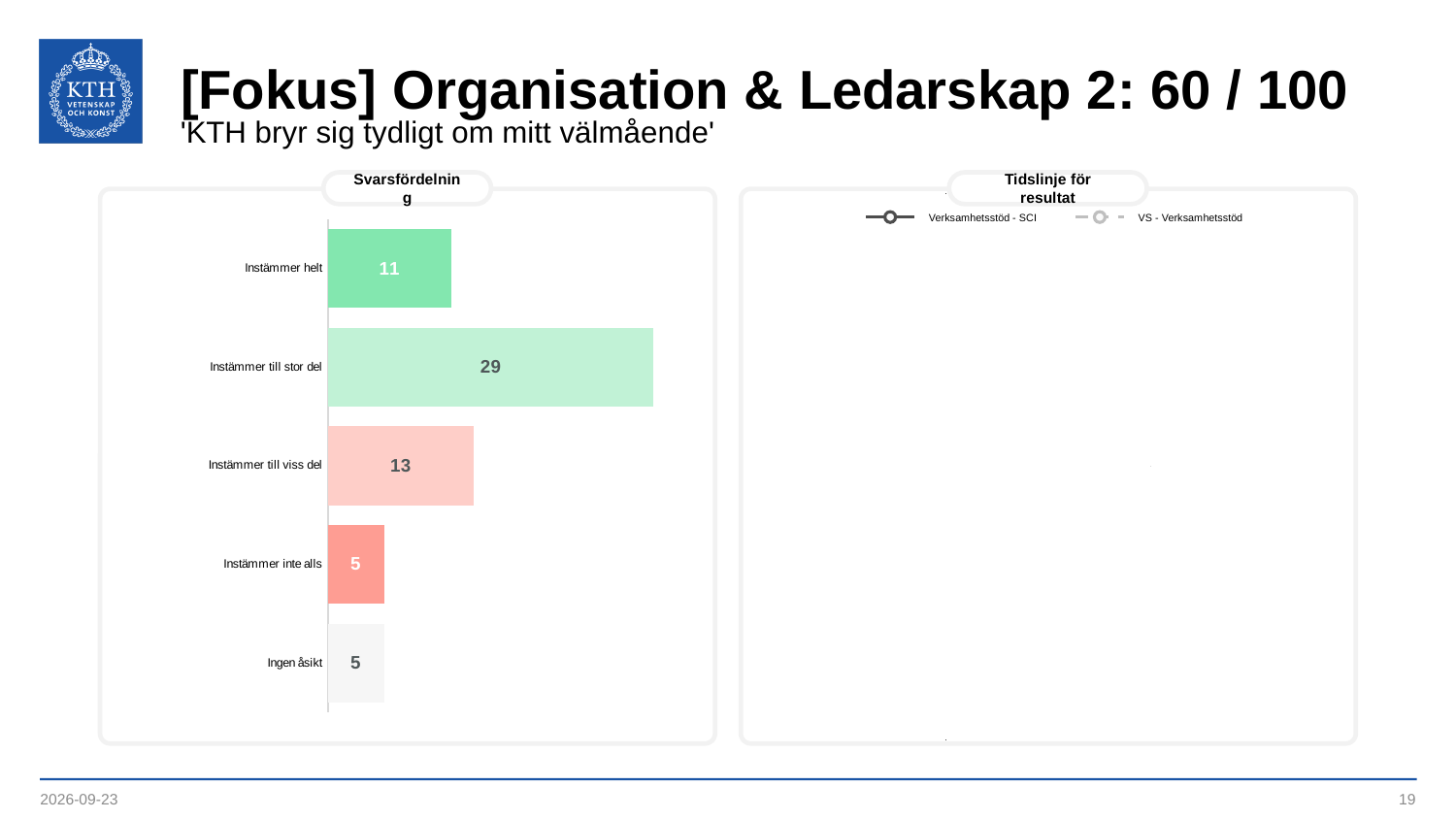
What kind of chart is the 'Svarsfördelning' chart? Bar chart How many categories does the 'Svarsfördelning' chart show? 5 In the 'Svarsfördelning' chart, what is the difference between 'Instämmer till viss del' and 'Instämmer inte alls'? 8 In the 'Svarsfördelning' chart, what is the value for 'Instämmer helt'? 11 In the 'Svarsfördelning' chart, what is the value for 'Instämmer till viss del'? 13 In the 'Svarsfördelning' chart, what is the value for 'Ingen åsikt'? 5 In the 'Svarsfördelning' chart, which category has the highest value? Instämmer till stor del In the 'Svarsfördelning' chart, which is larger: 'Instämmer helt' or 'Instämmer till viss del'? Instämmer till viss del In the 'Svarsfördelning' chart, what is the value for 'Instämmer inte alls'? 5 In the 'Svarsfördelning' chart, what is the value for 'Instämmer till stor del'? 29 In the 'Svarsfördelning' chart, what is the difference between 'Instämmer till stor del' and 'Instämmer helt'? 18 How many series does the legend of the 'Tidslinje för resultat' chart list? 2